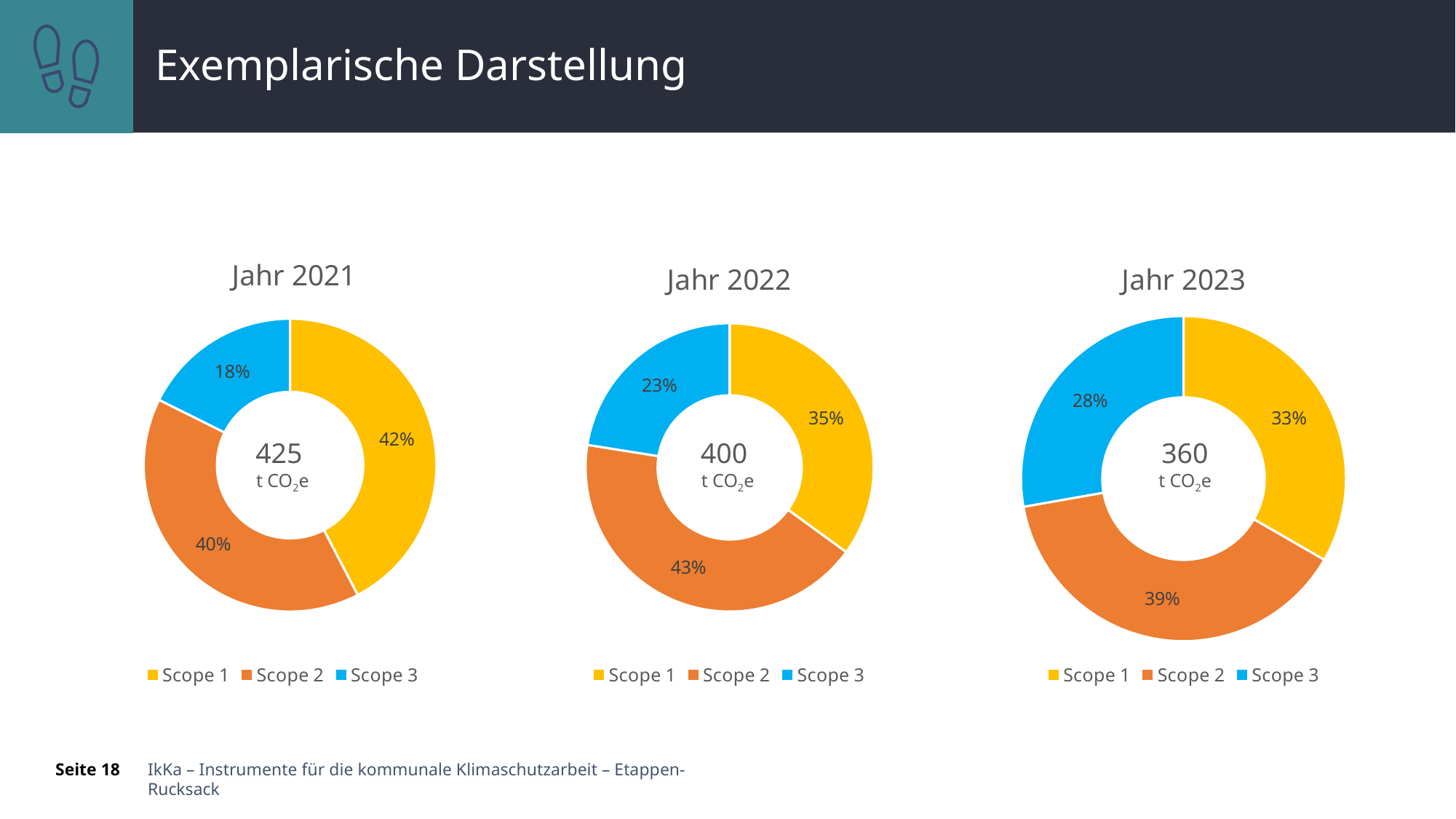
How many charts are on the slide? 3 In the 'Jahr 2021' chart, which scope has the smallest share? Scope 3 What kind of chart is the 'Jahr 2023' chart? Doughnut chart In the 'Jahr 2022' chart, what share does Scope 2 have? 43% In the 'Jahr 2022' chart, which scope has the largest share? Scope 2 In the 'Jahr 2023' chart, which scope has the largest share? Scope 2 In the 'Jahr 2021' chart, what share does Scope 1 have? 42% What total value is shown in the centre of the 'Jahr 2022' chart? 400 t CO2e In the 'Jahr 2023' chart, is the share of Scope 1 or Scope 2 larger? Scope 2 In the 'Jahr 2021' chart, what is the difference between the Scope 1 and Scope 3 shares? 24 percentage points In the 'Jahr 2023' chart, what share does Scope 3 have? 28% How many series does the legend of the 'Jahr 2021' chart list? 3